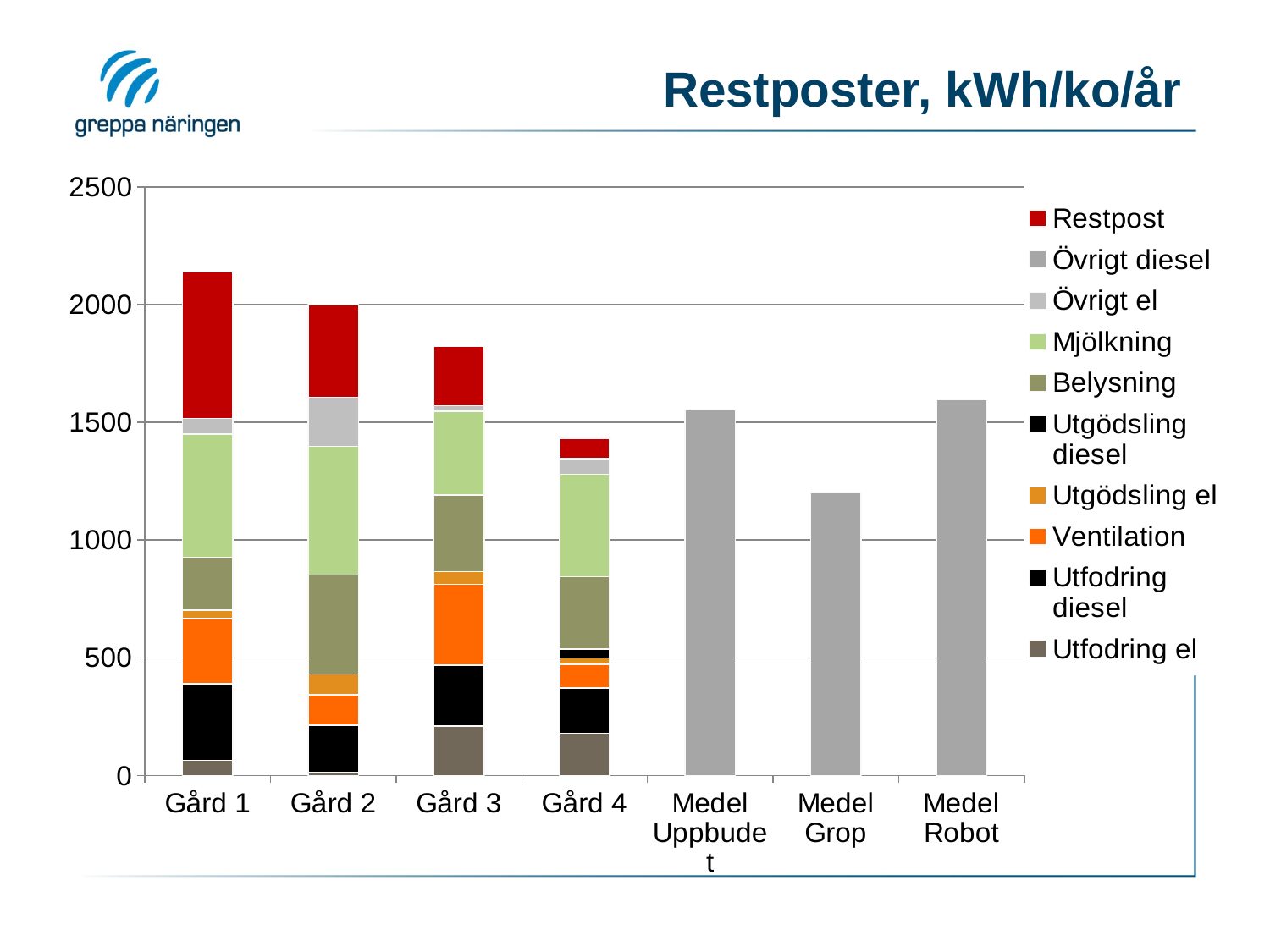
Which category has the highest total bar? Gård 1 Which colour represents the Restpost series in the legend? Red What is the title of the chart? Restposter, kWh/ko/år Is the value for Medel Grop greater or less than 1500? less Which category has the lowest total bar? Medel Grop Is the total for Gård 1 greater or less than 2000? greater Is the value for Medel Robot greater or less than 1500? greater Which has the larger total bar, Gård 3 or Gård 4? Gård 3 What kind of chart is shown on the slide? Stacked bar chart How many categories are shown along the x axis? 7 How many series does the legend list? 10